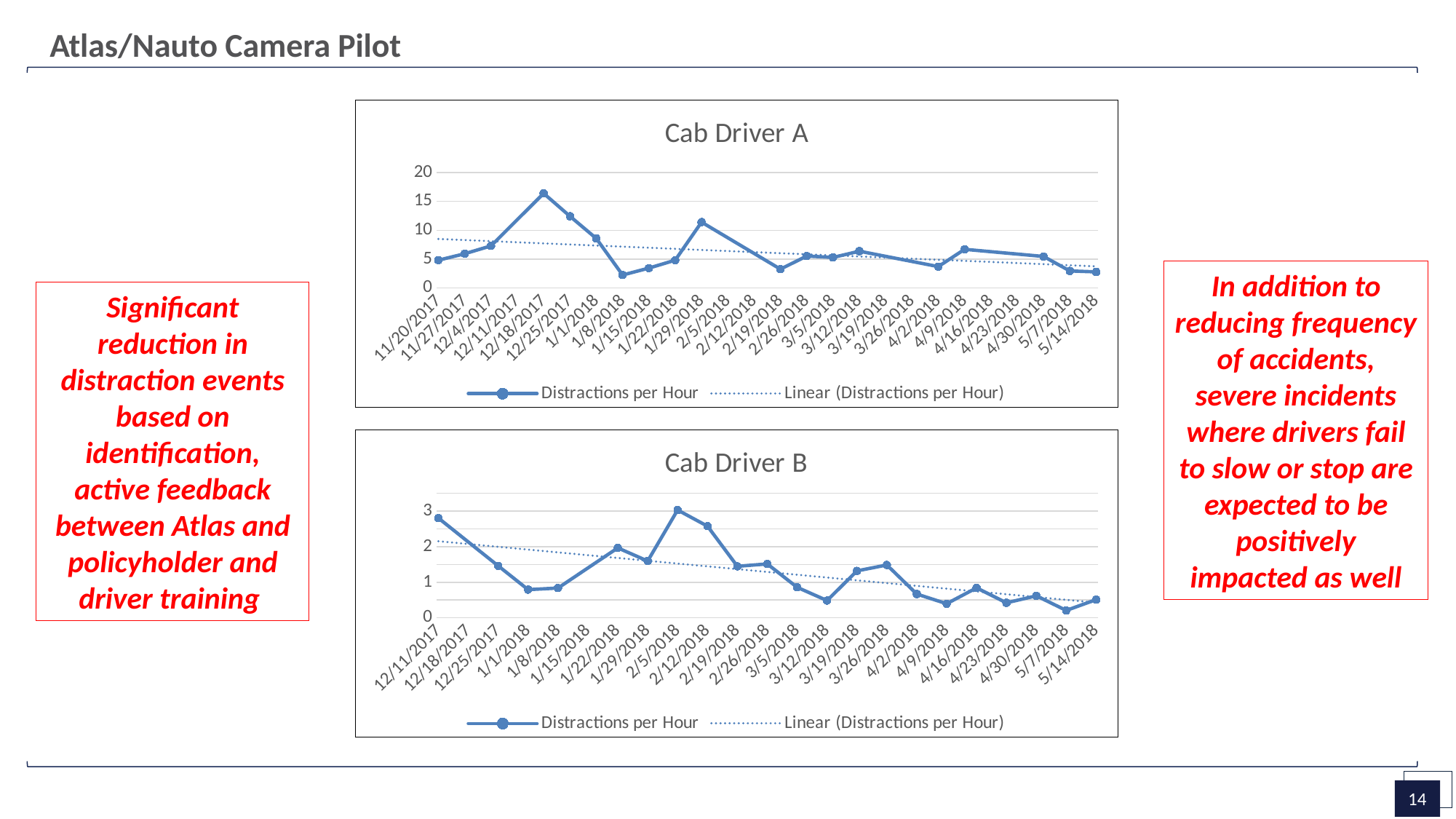
In the Cab Driver A chart, which date has the highest Distractions per Hour value? 12/18/2017 In the Cab Driver B chart, is the Distractions per Hour value for 2/5/2018 greater or less than 2? greater How many dates are plotted on the x axis of the Cab Driver B chart? 23 In the Cab Driver A chart, is the Distractions per Hour value for 1/8/2018 greater or less than 5? less How many entries does the legend of the Cab Driver A chart list? 2 In the Cab Driver A chart, is the Distractions per Hour value for 12/18/2017 greater or less than 15? greater How many dates are plotted on the x axis of the Cab Driver A chart? 26 In the Cab Driver A chart, does the dotted linear trend line rise or fall from left to right? fall What kind of chart is the Cab Driver A chart? line chart In the Cab Driver A chart, which is larger: the value for 12/18/2017 or the value for 1/29/2018? 12/18/2017 In the Cab Driver B chart, which is larger: the value for 12/11/2017 or the value for 1/1/2018? 12/11/2017